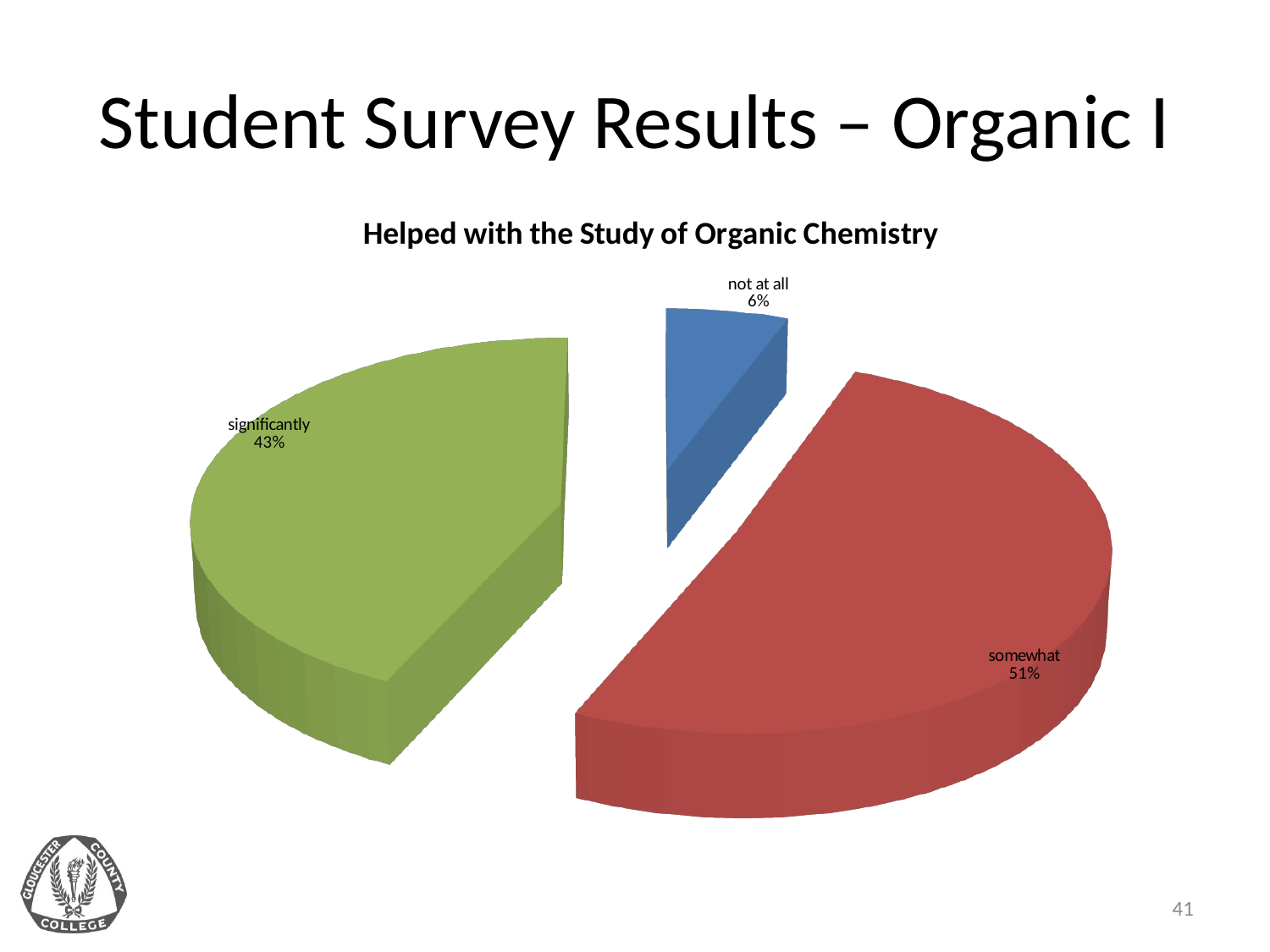
Which is larger, the share for "significantly" or the share for "not at all"? significantly What is the title of the chart? Helped with the Study of Organic Chemistry Which response has the smallest share of the pie? not at all What percentage of students answered "not at all"? 6% What is the difference in percentage points between "somewhat" and "significantly"? 8 What percentage of students answered "significantly"? 43% What percentage of students answered "somewhat"? 51% How many slices does the pie chart have? 3 What kind of chart is shown on the slide? pie chart What colour is the "not at all" slice? blue Which response has the largest share of the pie? somewhat What is the combined share of "somewhat" and "significantly"? 94%